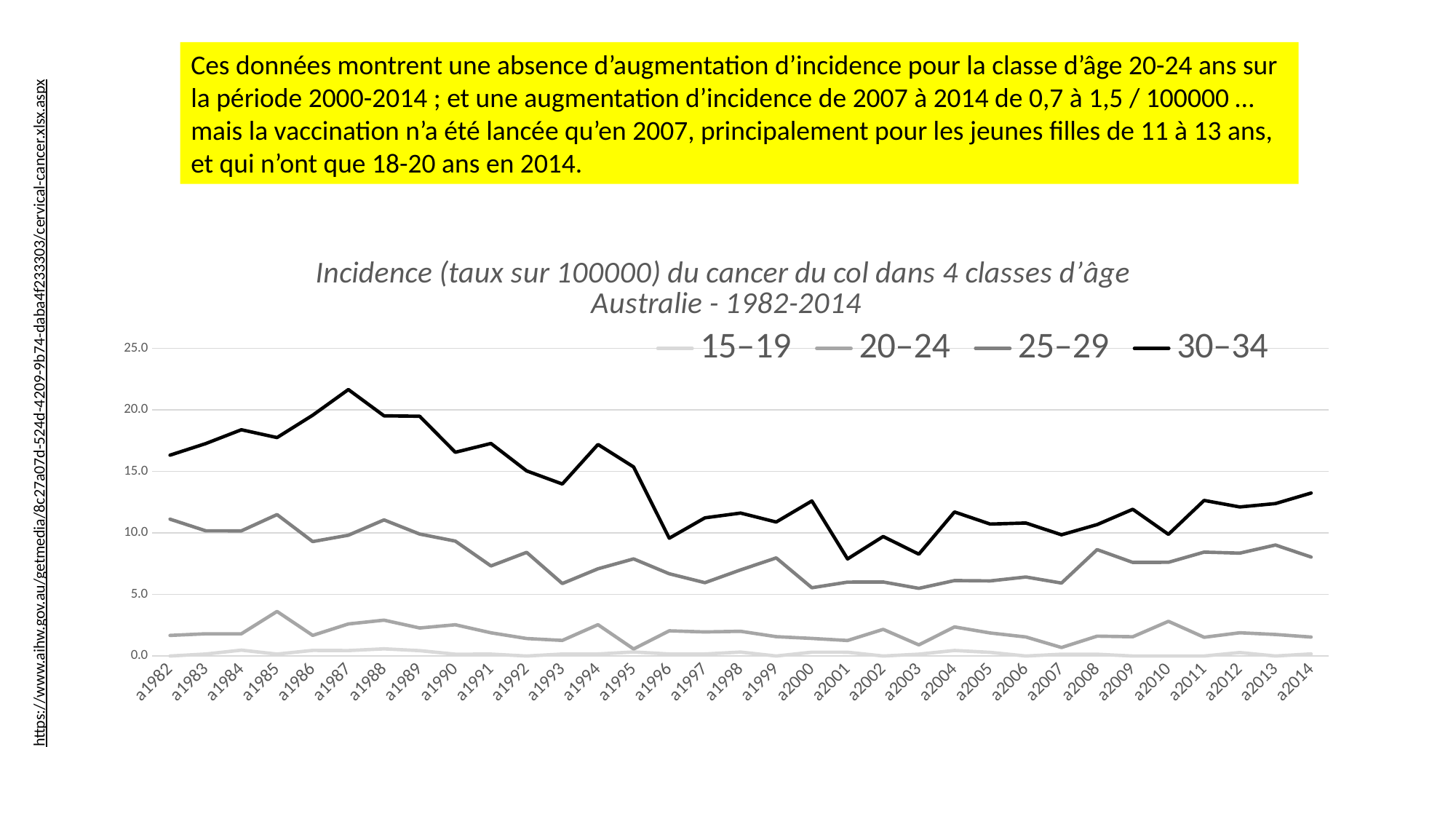
Which series has the highest values across the whole period? 30–34 Is the value for the 25–29 series in a1985 greater or less than 10.0? greater Is the value for the 30–34 series in a2001 greater or less than 10.0? less What kind of chart is shown on the slide? line chart How many years are plotted along the x axis? 33 Is the value for the 30–34 series in a1987 greater or less than 20.0? greater Which is larger in a1987, the value for 30–34 or the value for 25–29? 30–34 Which series has the lowest values across the whole period? 15–19 How many series does the legend list? 4 Does the 30–34 series overall rise or fall from a1982 to a2014? fall In which year does the 30–34 series reach its highest value? a1987